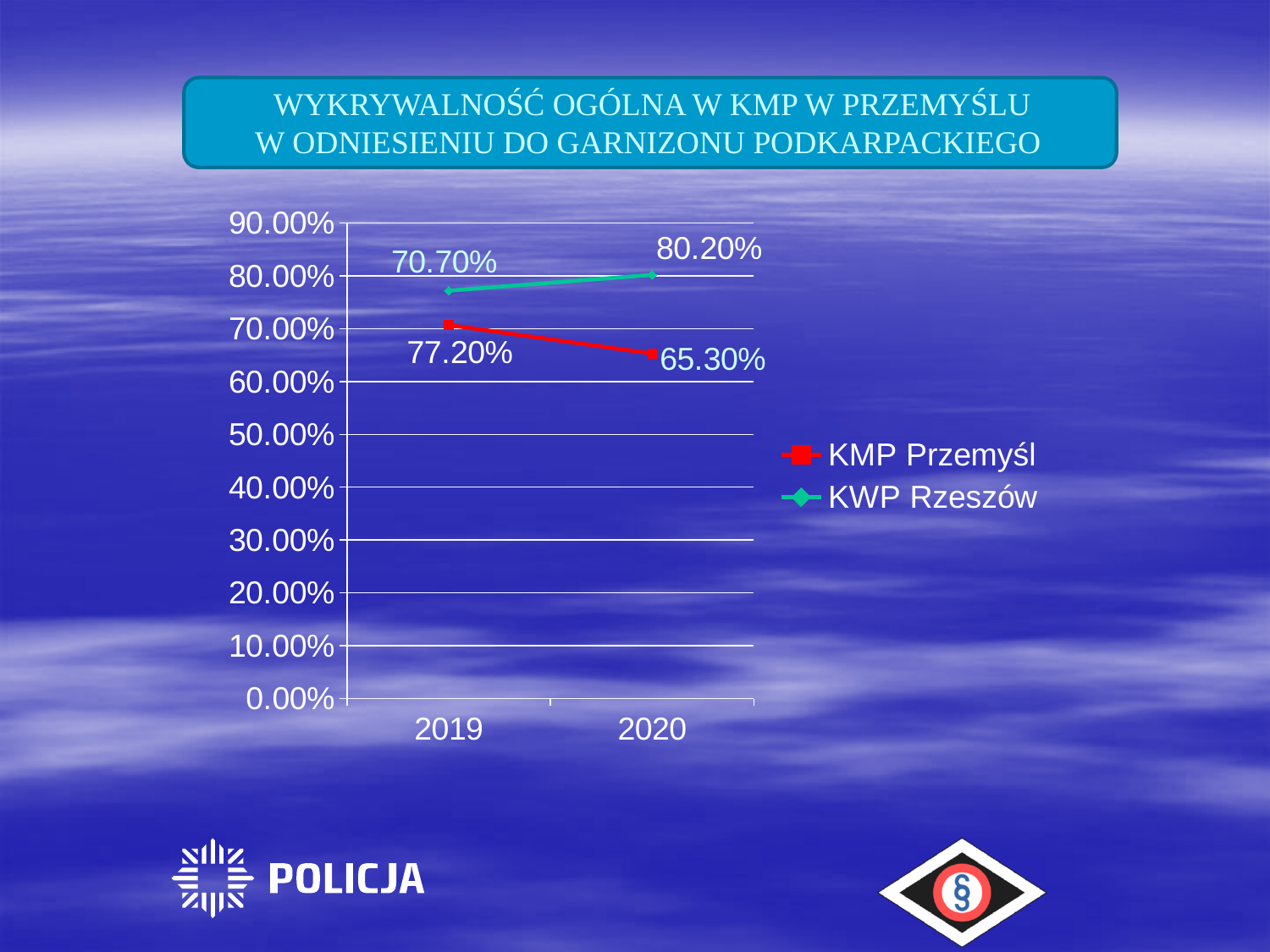
How many series does the legend list? 2 Which series is drawn in red? KMP Przemyśl What kind of chart is shown on the slide? line chart Is the value for KWP Rzeszów in 2019 greater or less than 80.00%? less How many years are shown on the x axis? 2 Which series has the higher value in 2020, KMP Przemyśl or KWP Rzeszów? KWP Rzeszów Does the KWP Rzeszów line rise or fall from 2019 to 2020? rise What is the difference between the KWP Rzeszów and KMP Przemyśl values in 2020? 14.90% What is the value for KWP Rzeszów in 2020? 80.20% What is the value for KMP Przemyśl in 2020? 65.30% Does the KMP Przemyśl line rise or fall from 2019 to 2020? fall Is the value for KMP Przemyśl in 2020 greater or less than 60.00%? greater